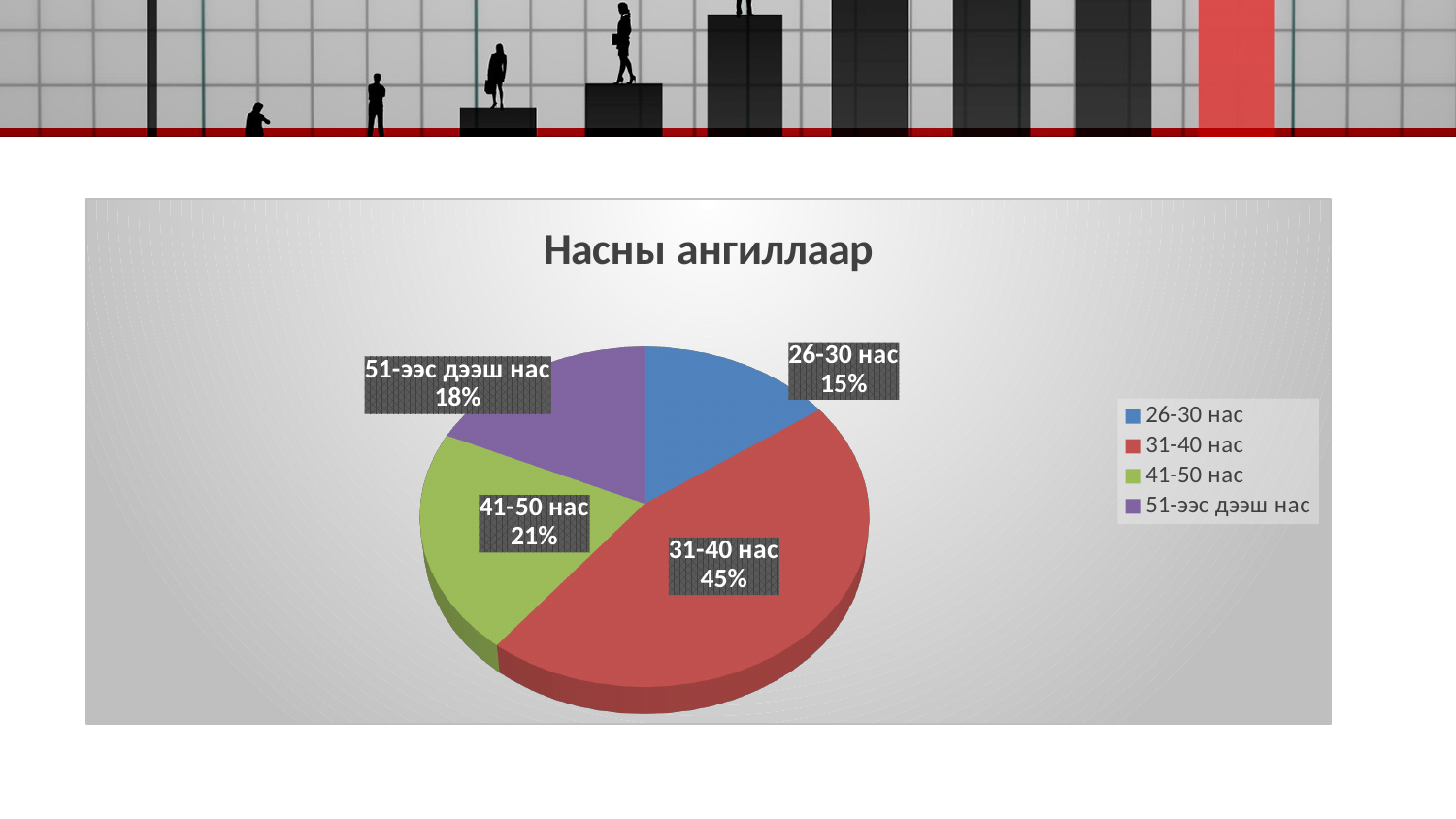
Which age category has the smallest slice? 26-30 нас What type of chart is shown on the slide? pie chart Which is larger, the 41-50 нас slice or the 51-ээс дээш нас slice? 41-50 нас What is the value shown for 41-50 нас? 21% What is the value shown for 26-30 нас? 15% What colour is the 31-40 нас slice? red Which age category has the largest slice? 31-40 нас How many categories does the pie chart have? 4 What is the title of the chart? Насны ангиллаар What is the difference between the 31-40 нас and 41-50 нас shares? 24% What is the value shown for 51-ээс дээш нас? 18% What share of the pie does the 31-40 нас slice represent? 45%